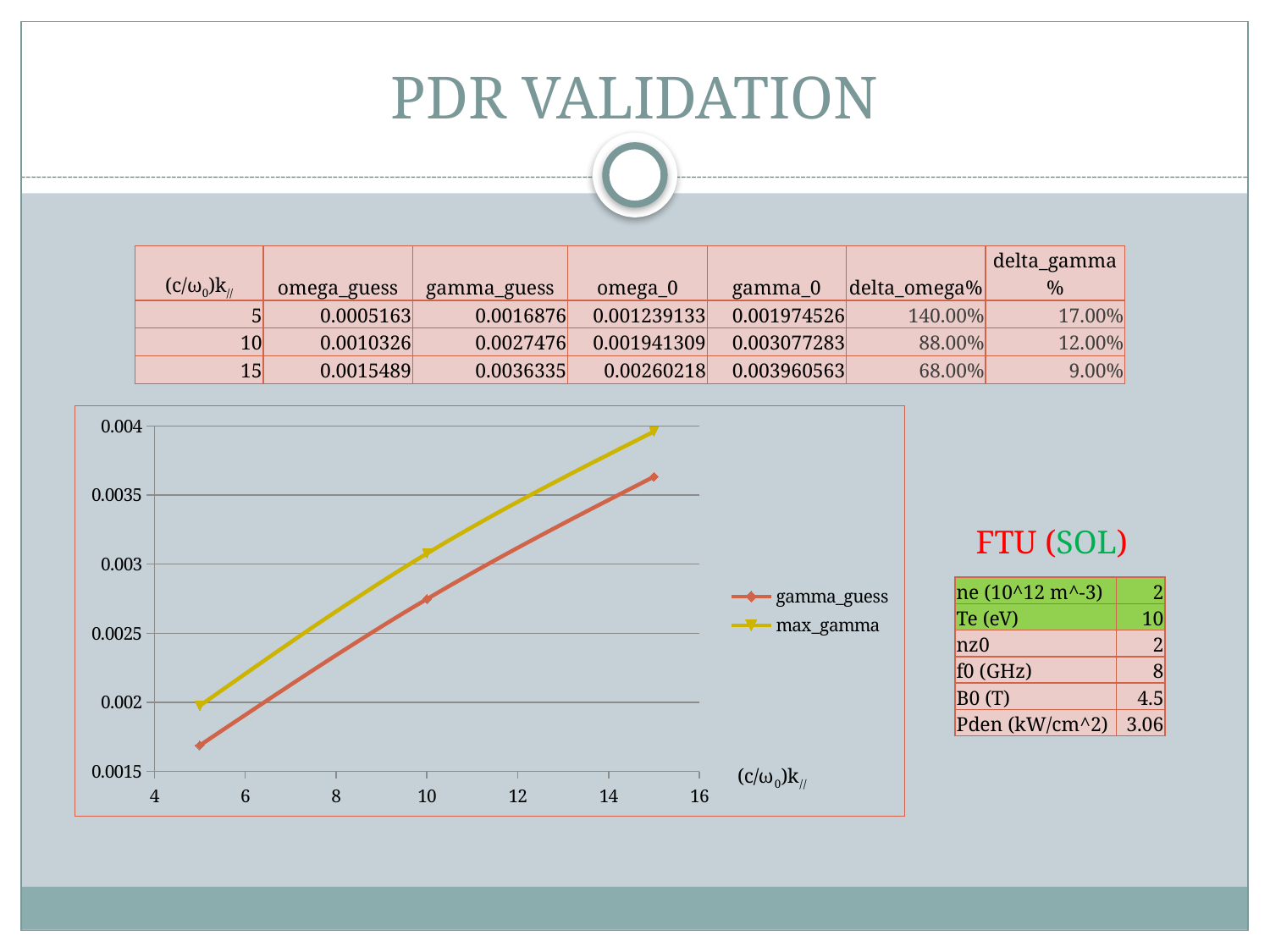
At (c/ω0)k// = 10, which series has the larger value, gamma_guess or max_gamma? max_gamma Is the gamma_guess value at (c/ω0)k// = 5 greater or less than 0.002? less What kind of chart is shown on the slide? line chart Which series is plotted in yellow in the chart? max_gamma How many data points are plotted for the gamma_guess series? 3 Do the values of the max_gamma series rise or fall as (c/ω0)k// increases? rise Do the values of the gamma_guess series rise or fall along the x axis? rise What is the label of the chart's x axis? (c/ω0)k// How many series does the chart's legend list? 2 Is the gamma_guess value at (c/ω0)k// = 15 greater or less than 0.0035? greater Is the gamma_guess value at (c/ω0)k// = 10 greater or less than 0.003? less